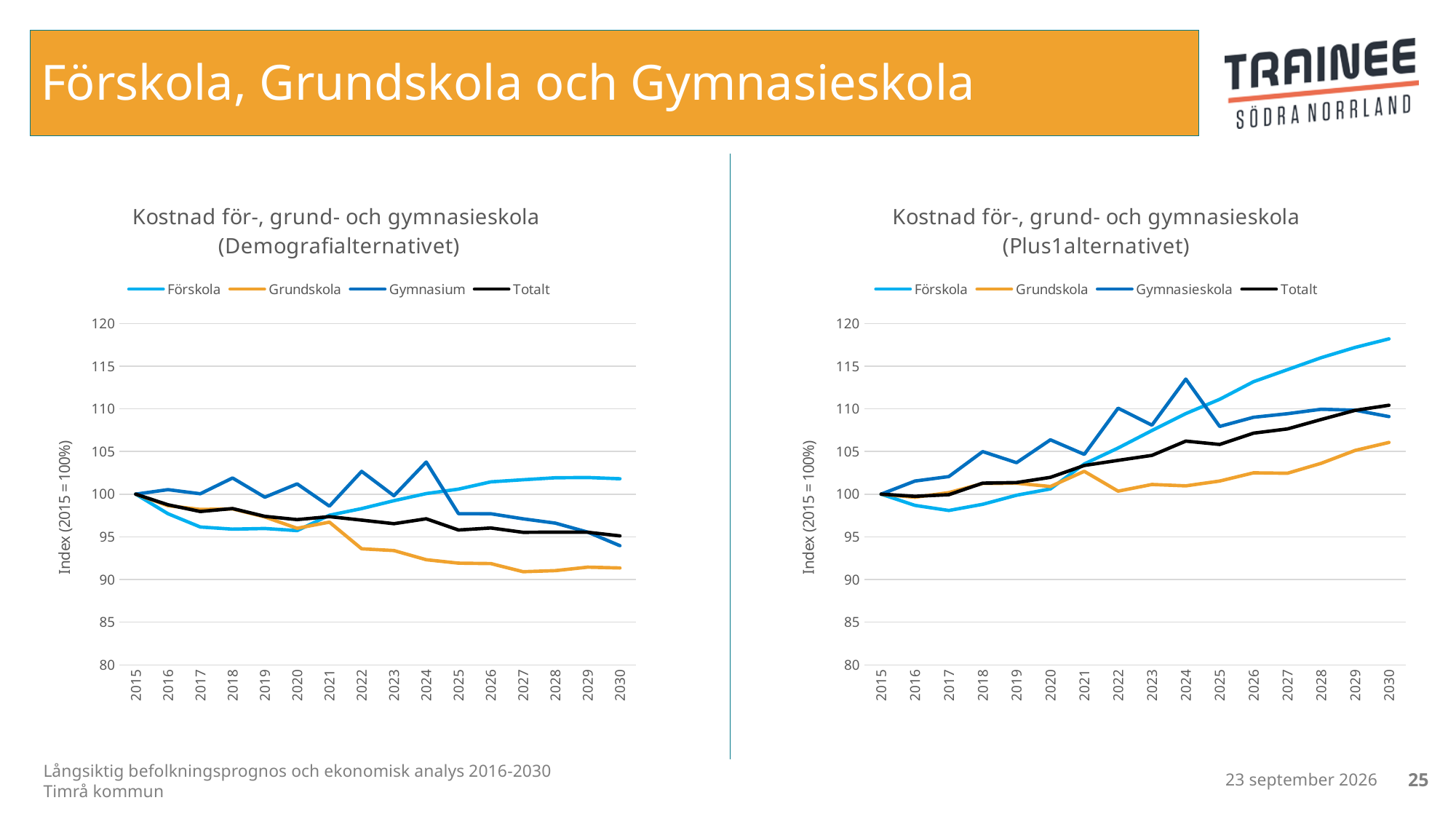
In the left chart (Demografialternativet), what is the index value for Totalt in 2015? 100 In the right chart (Plus1alternativet), is the value for Förskola in 2030 greater or less than 115? greater What is the y-axis label of the left chart (Demografialternativet)? Index (2015 = 100%) In the right chart (Plus1alternativet), does the Totalt line rise or fall from 2015 to 2030? rise In the right chart (Plus1alternativet), is the value for Gymnasieskola in 2024 greater or less than 110? greater What type of chart is the left chart (Demografialternativet)? line chart In the left chart (Demografialternativet), is the value for Grundskola in 2030 greater or less than 95? less How many years are plotted along the x axis of the left chart (Demografialternativet)? 16 In the left chart (Demografialternativet), does the Grundskola line rise or fall from 2015 to 2030? fall In the right chart (Plus1alternativet), which series has the highest value in 2030? Förskola How many series does the legend of the right chart (Plus1alternativet) list? 4